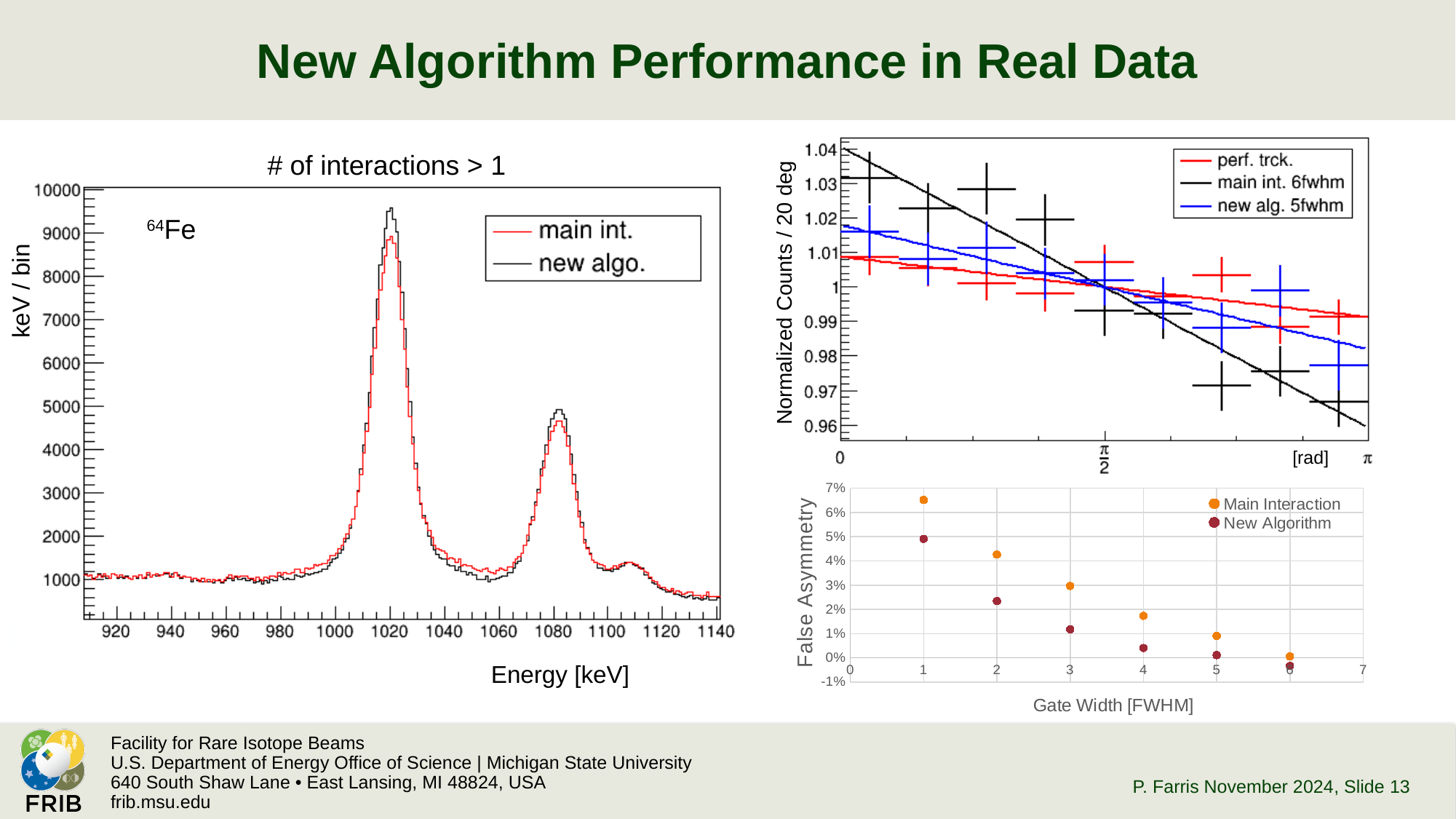
In the top-right chart (Normalized Counts / 20 deg), is the 'main int. 6fwhm' line at 0 rad greater or less than 1.03? greater In the left chart (energy spectrum), what kind of chart is it? line chart In the bottom-right chart (False Asymmetry), how many series does the legend list? 2 In the bottom-right chart (False Asymmetry), how many data points are plotted for the 'Main Interaction' series? 6 In the left chart (energy spectrum), what is the label on the x axis? Energy [keV] In the left chart (energy spectrum), is the peak value of the 'new algo.' series near 1020 keV greater or less than 9000? greater In the top-right chart (Normalized Counts / 20 deg), how many series does the legend list? 3 In the left chart (energy spectrum), is the peak value of the 'main int.' series near 1080 keV greater or less than 4000? greater In the bottom-right chart (False Asymmetry), at which gate width is the 'Main Interaction' value highest? 1 In the left chart (energy spectrum), how many series does the legend list? 2 In the top-right chart (Normalized Counts / 20 deg), do the fitted lines rise or fall along the x axis? fall In the bottom-right chart (False Asymmetry), at gate width 1, which series has the larger value, 'Main Interaction' or 'New Algorithm'? Main Interaction